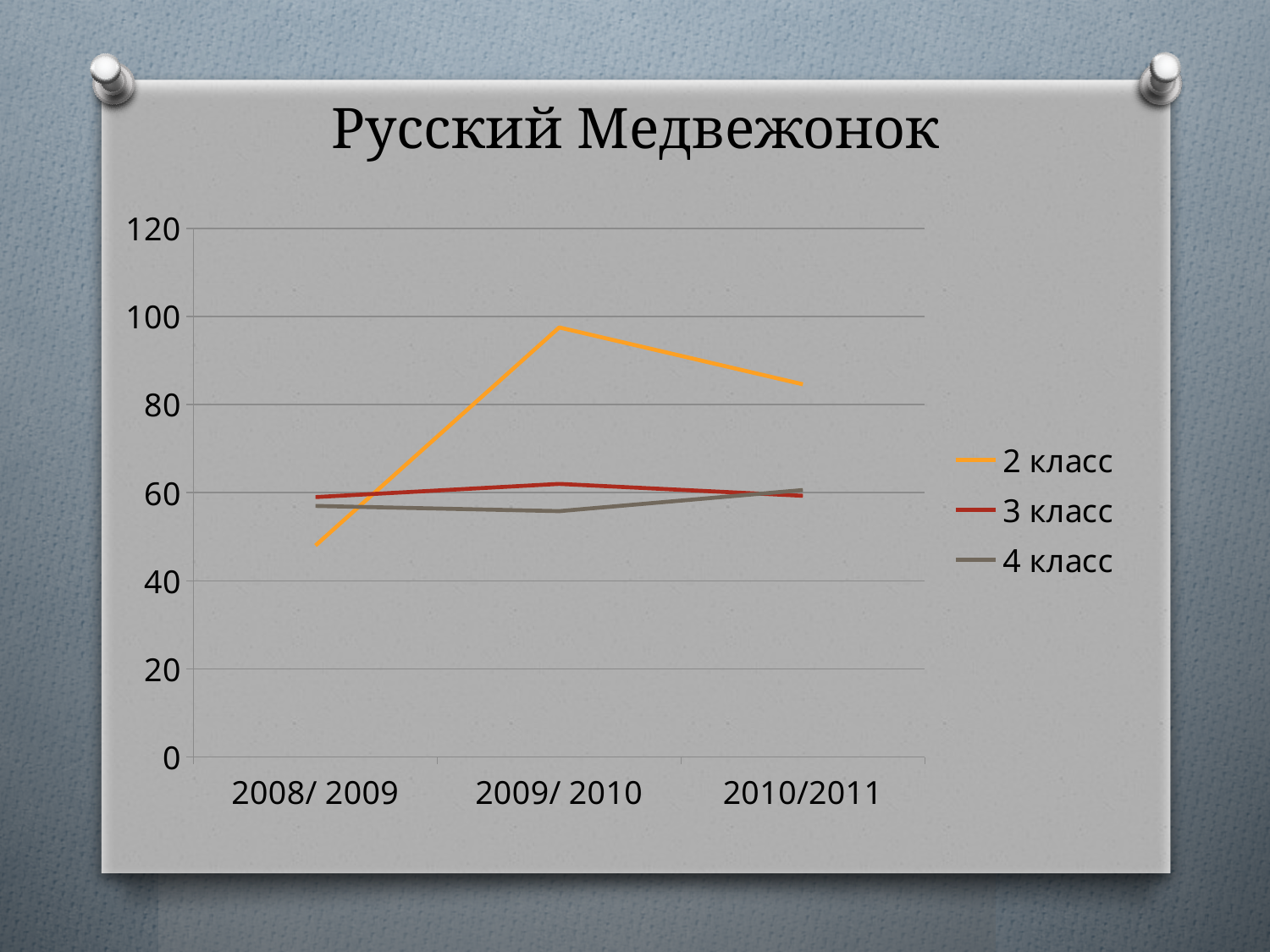
What is the title of the chart? Русский Медвежонок What kind of chart is shown on the slide? line chart How many series does the legend list? 3 How many categories are shown on the x axis? 3 Does the 2 класс series rise or fall from 2009/ 2010 to 2010/2011? fall In which school year does the 2 класс series reach its highest value? 2009/ 2010 Is the value for 2 класс in 2009/ 2010 greater or less than 80? greater Which series has the larger value in 2010/2011, 2 класс or 4 класс? 2 класс Which series is drawn in orange in the legend? 2 класс Is the value for 2 класс in 2008/ 2009 greater or less than 60? less Is the value for 3 класс in 2009/ 2010 greater or less than 80? less In which school year does the 2 класс series have its lowest value? 2008/ 2009